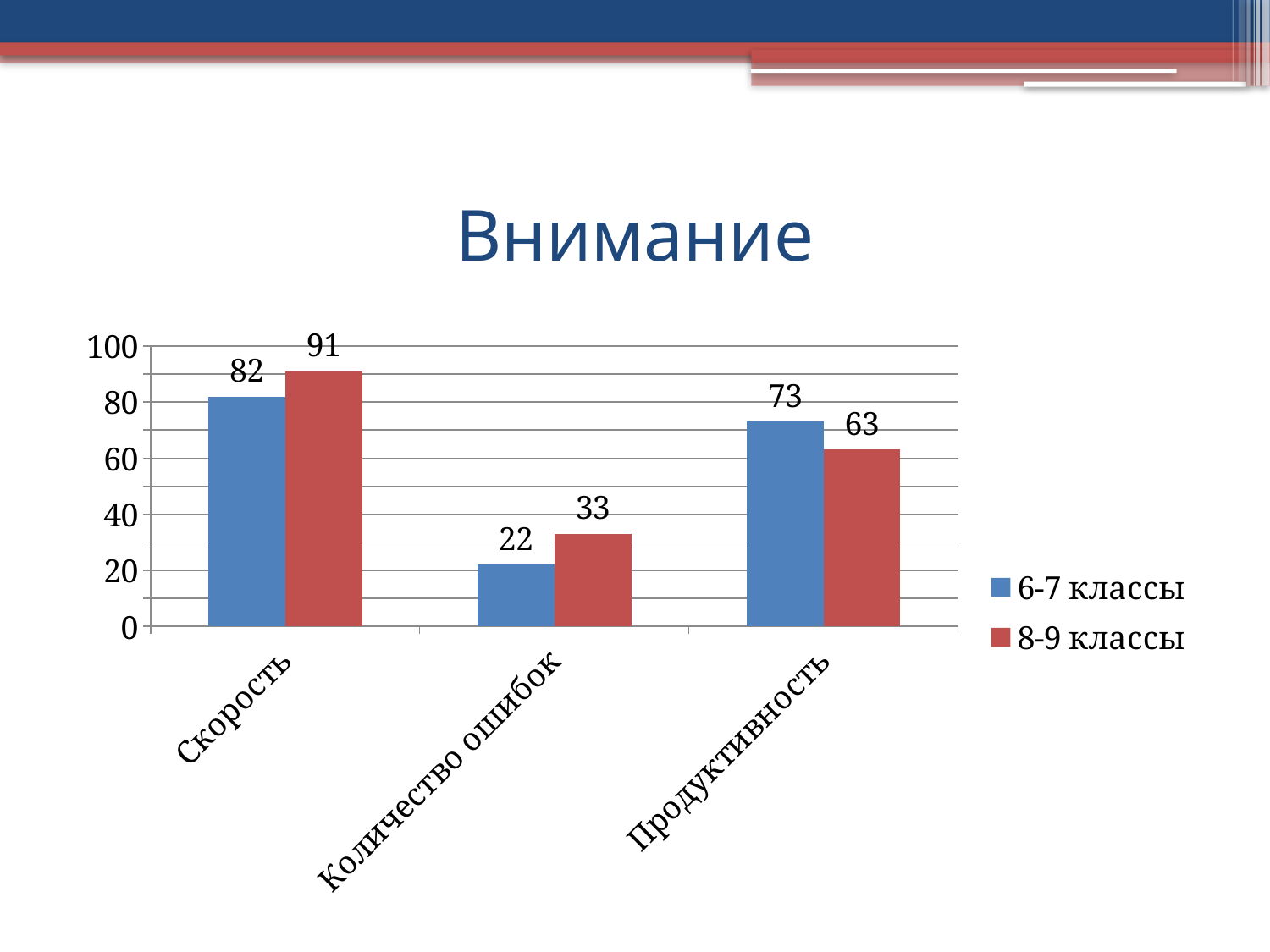
What kind of chart is shown on the slide? Bar chart What is the value for 6-7 классы in the Скорость category? 82 What is the difference between the 6-7 классы and 8-9 классы values in the Продуктивность category? 10 Which category has the highest value for 8-9 классы? Скорость How many categories are shown on the x axis? 3 What is the difference between the 8-9 классы and 6-7 классы values in the Скорость category? 9 What is the value for 8-9 классы in the Количество ошибок category? 33 In the Продуктивность category, which series has the larger value, 6-7 классы or 8-9 классы? 6-7 классы What is the value for 8-9 классы in the Продуктивность category? 63 What is the title of the slide? Внимание Which category has the lowest value for 6-7 классы? Количество ошибок How many series does the legend list? 2